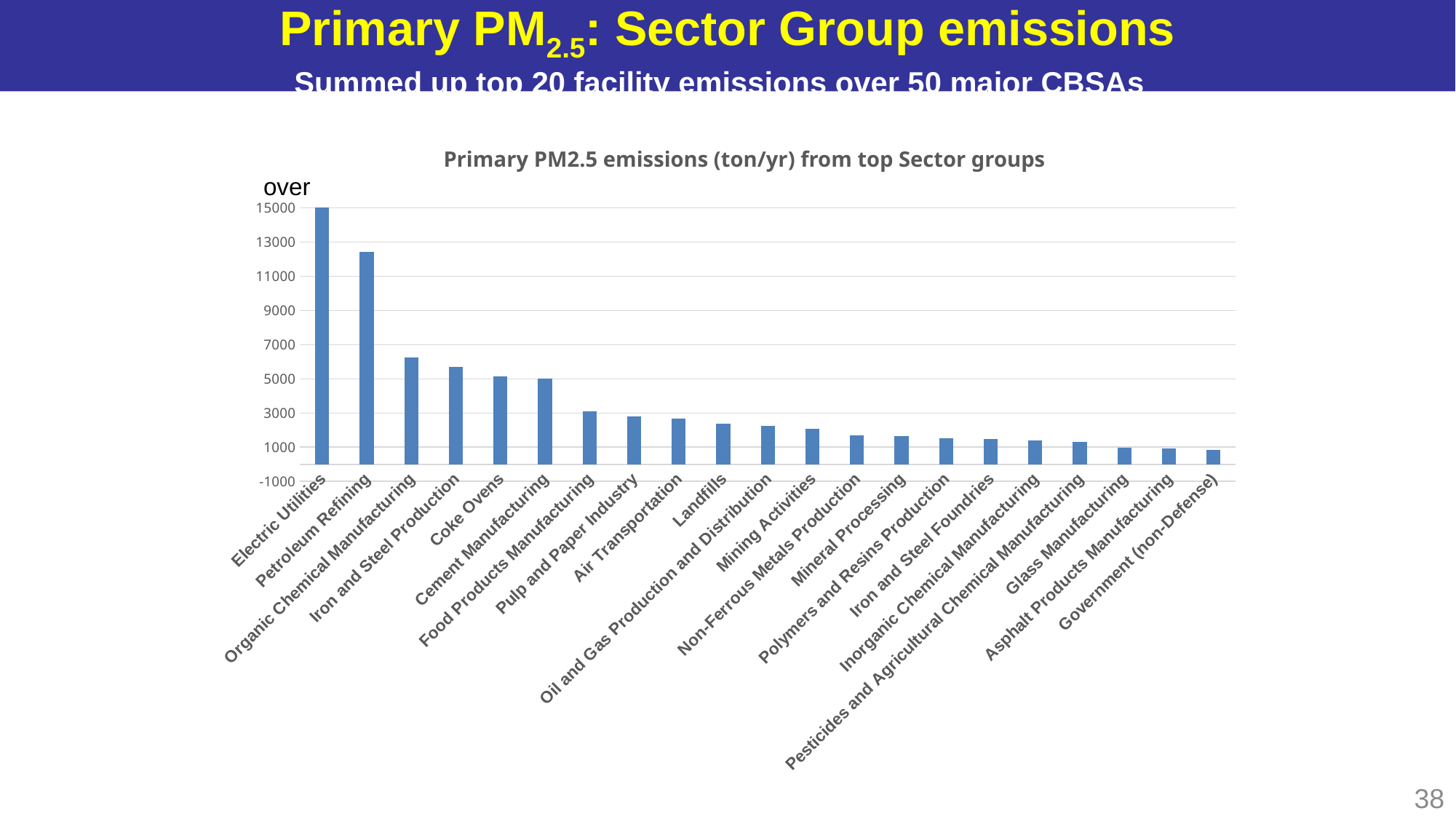
Which has higher emissions, Landfills or Mining Activities? Landfills Do the bar values rise or fall from left to right along the x axis? fall Which sector group has the lowest primary PM2.5 emissions? Government (non-Defense) Which sector group has the highest primary PM2.5 emissions? Electric Utilities Which has higher emissions, Petroleum Refining or Iron and Steel Production? Petroleum Refining Is the value for Petroleum Refining greater or less than 11000? greater What is the title of the chart? Primary PM2.5 emissions (ton/yr) from top Sector groups Is the value for Organic Chemical Manufacturing greater or less than 7000? less What kind of chart is shown on the slide? bar chart How many sector groups are plotted in the chart? 21